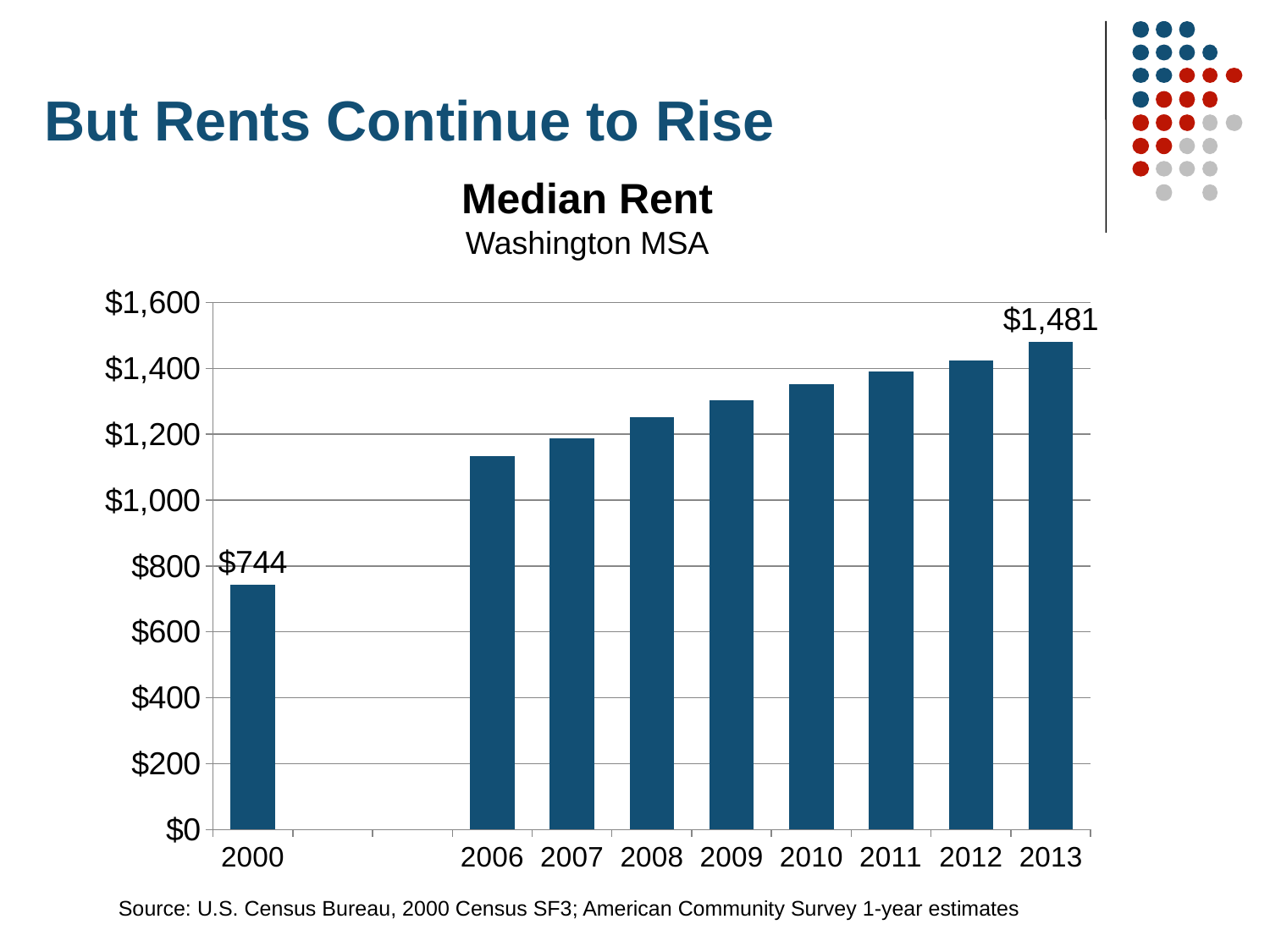
Which year has a higher median rent, 2006 or 2010? 2010 How many years are shown with bars in the chart? 9 Is the median rent for 2012 greater or less than $1,400? greater Do median rents rise or fall from 2006 to 2013? Rise Is the median rent for 2008 greater or less than $1,200? greater Which year has the lowest median rent? 2000 What is the median rent shown for 2013? $1,481 Which year has the highest median rent? 2013 What is the median rent shown for 2000? $744 What kind of chart is shown on the slide? Bar chart What is the difference between the median rent in 2013 and in 2000? $737 Is the median rent for 2006 greater or less than $1,200? less